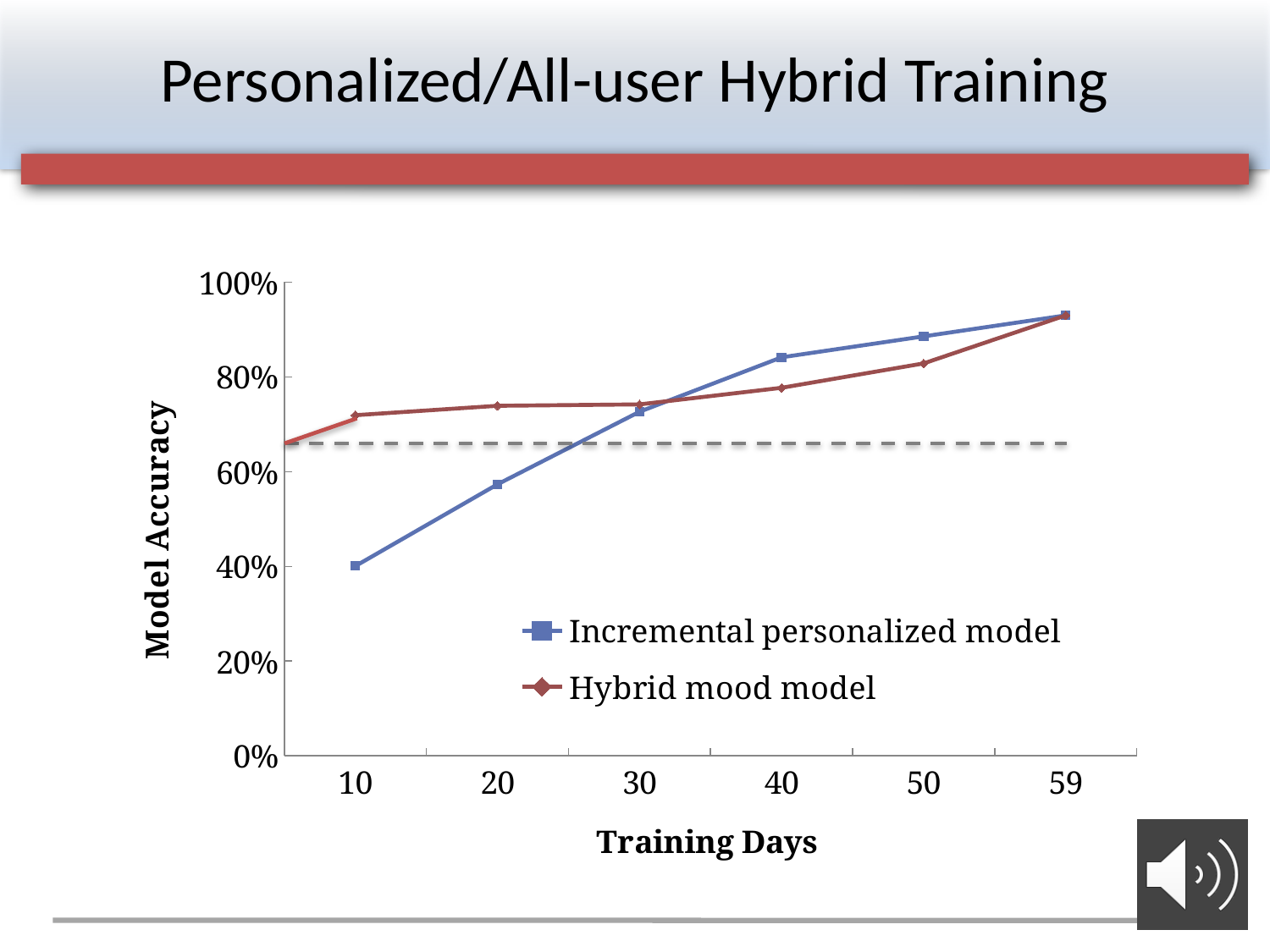
Is the value for the Incremental personalized model at 10 training days greater or less than 60%? less At 40 training days, which model has the higher accuracy? Incremental personalized model How many series does the legend list? 2 What is the label on the x axis? Training Days At 10 training days, which model has the higher accuracy? Hybrid mood model Is the value for the Hybrid mood model at 20 training days greater or less than 80%? less Is the value for the Hybrid mood model at 10 training days greater or less than 60%? greater What kind of chart is shown on the slide? line chart Does the accuracy of the Incremental personalized model rise or fall as training days increase? rise How many training-day points are marked on the x axis? 6 What is the label on the y axis? Model Accuracy